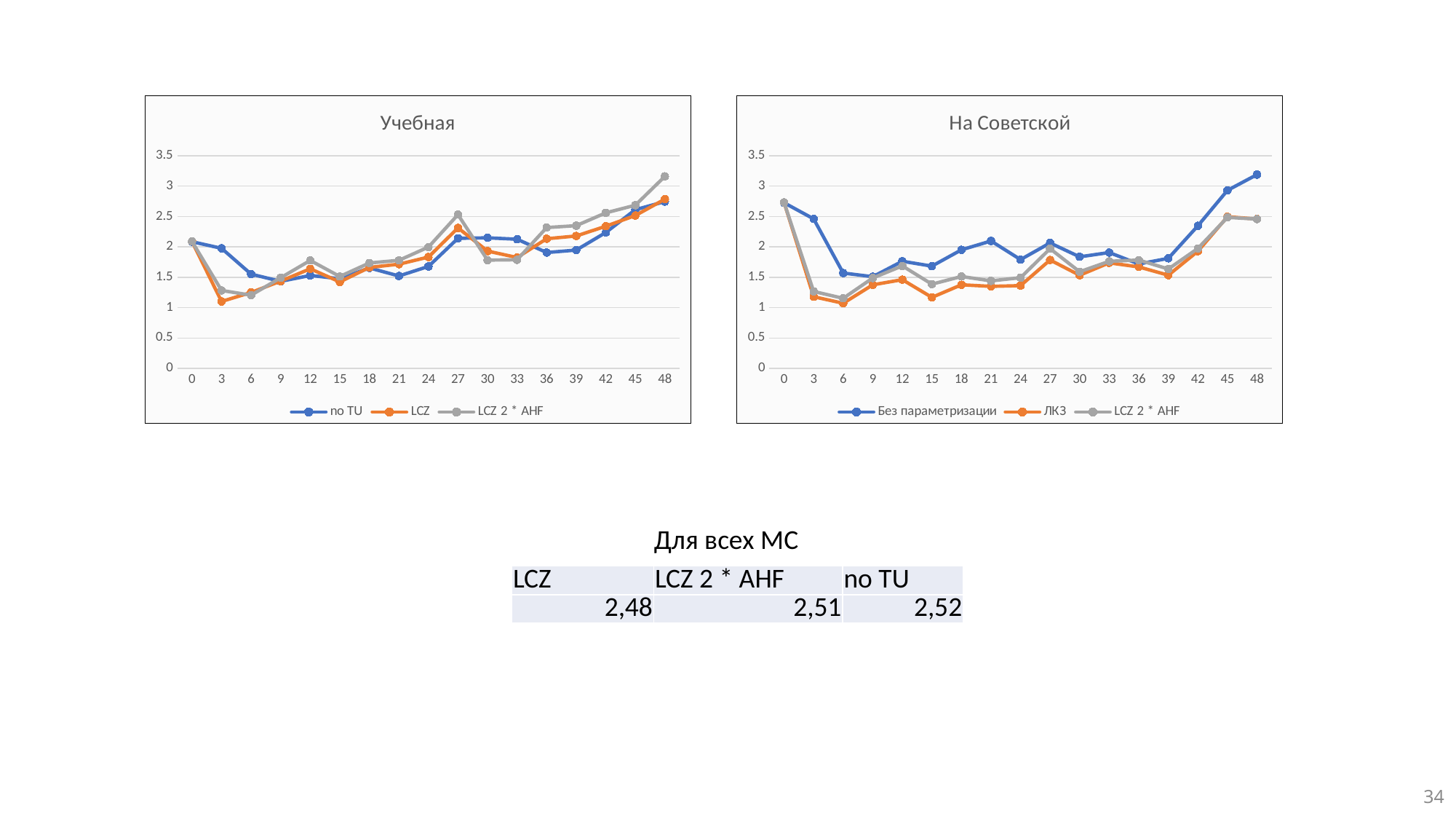
How many points along the x axis does each series in the chart titled "Учебная" have? 17 What kind of chart is the chart titled "Учебная"? line chart In the chart titled "Учебная", which series has the larger value at x = 48: LCZ 2 * AHF or no TU? LCZ 2 * AHF In the chart titled "На Советской", does the Без параметризации series rise or fall from x = 0 to x = 6? fall What is the title of the chart on the right side of the slide? На Советской In the chart titled "На Советской", which series has the larger value at x = 48: Без параметризации or ЛКЗ? Без параметризации In the chart titled "На Советской", is the value of ЛКЗ at x = 6 greater or less than 1.5? less In the chart titled "Учебная", is the value of LCZ 2 * AHF at x = 48 greater or less than 3? greater In the chart titled "На Советской", is the value of Без параметризации at x = 48 greater or less than 3? greater In the chart titled "Учебная", does the LCZ 2 * AHF series rise or fall from x = 36 to x = 48? rise How many series does the legend of the chart titled "На Советской" list? 3